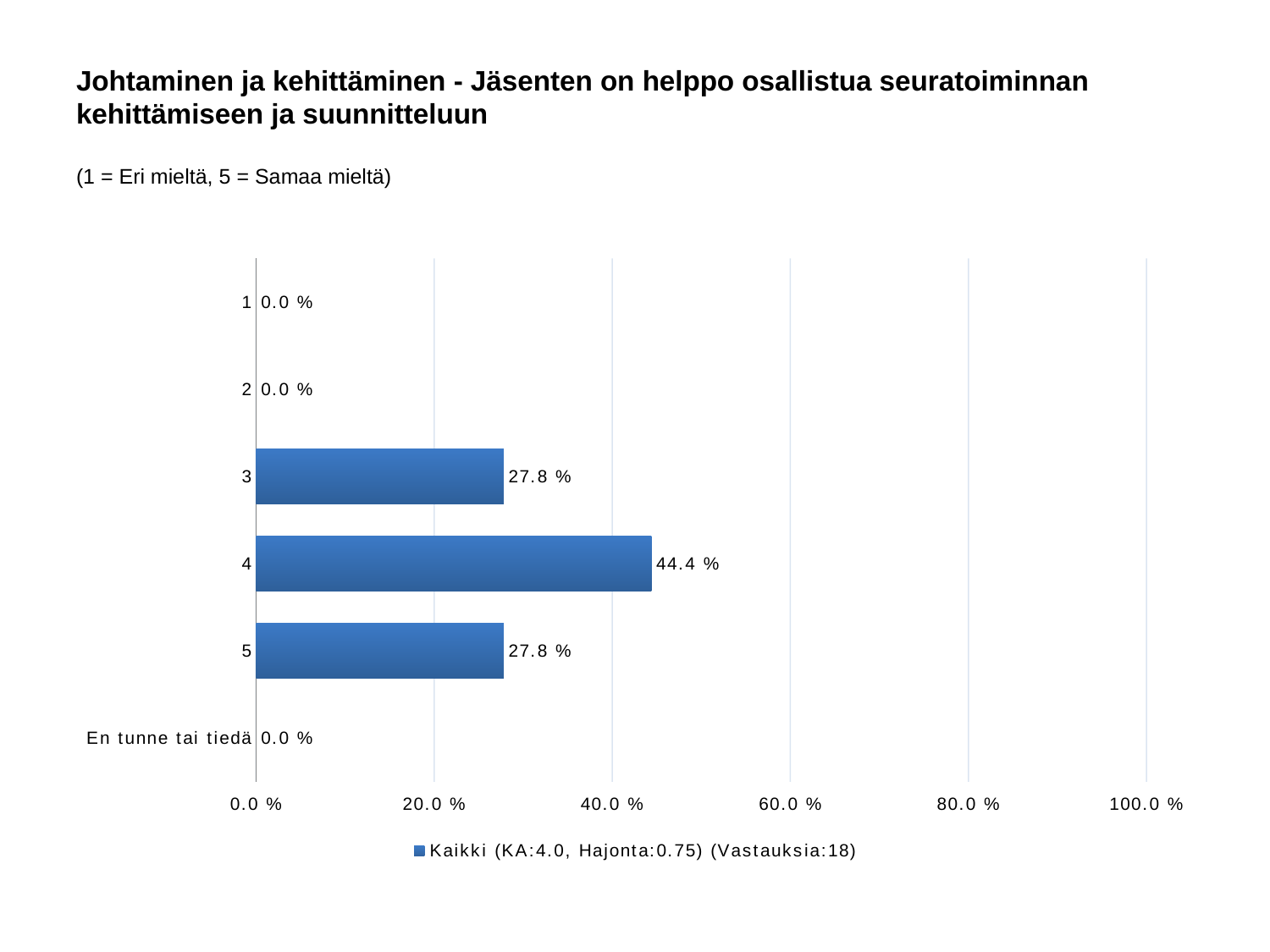
What kind of chart is shown on the slide? bar chart Which is larger, the value for category 4 or the value for category 3? 4 What is the difference between the values for category 4 and category 5? 16.6 % What is the value for category 4? 44.4 % Is the value for category 4 greater or less than 40.0 %? greater How many categories have a value of 0.0 %? 3 What is the legend entry for the series shown? Kaikki (KA:4.0, Hajonta:0.75) (Vastauksia:18) How many series does the legend list? 1 Which category has the highest value? 4 What is the value for the category "En tunne tai tiedä"? 0.0 % What is the value for category 3? 27.8 % How many categories are shown on the chart? 6